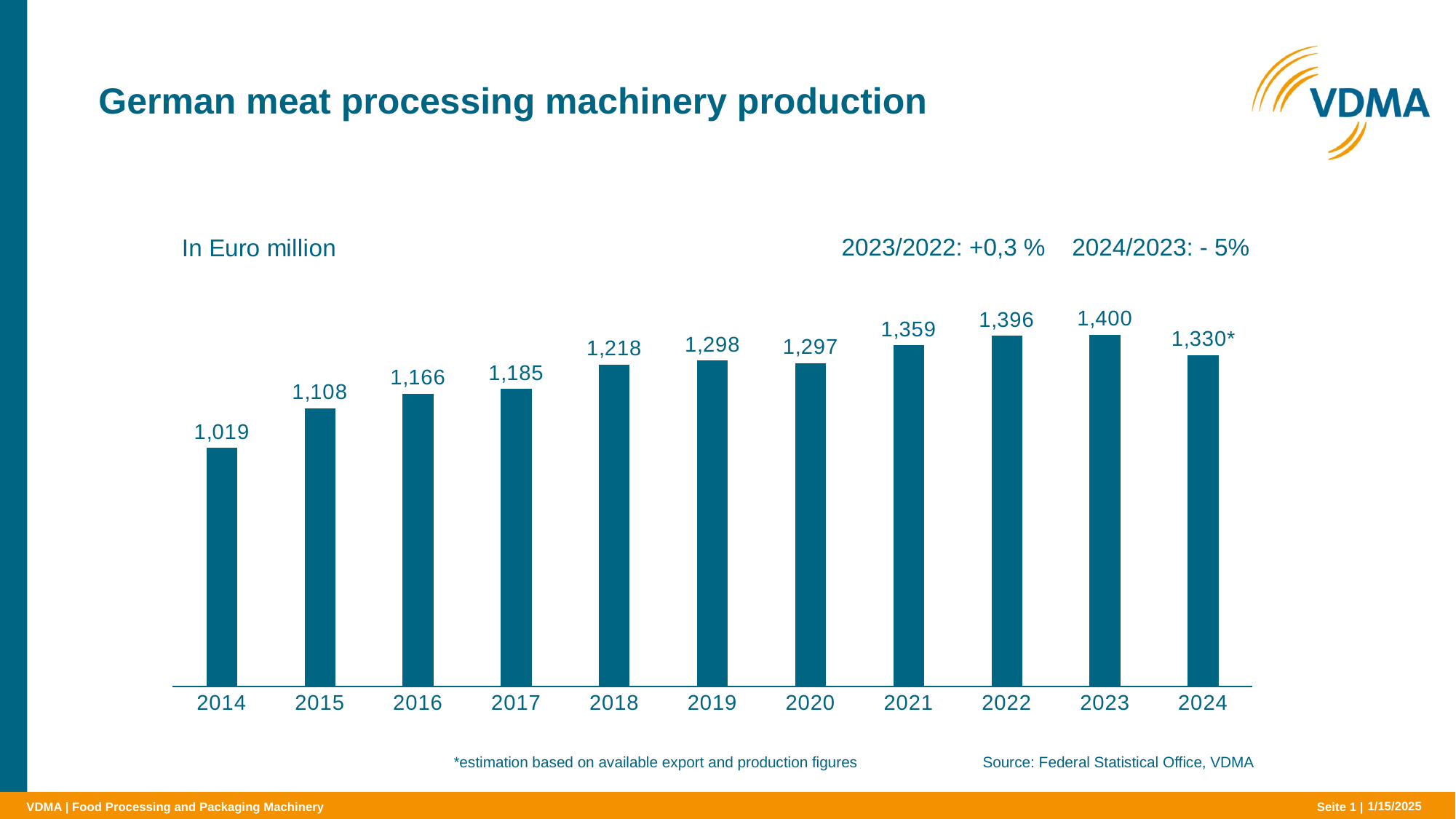
Which year has the highest value? 2023 What is the difference between the values for 2015 and 2014? 89 What is the value for 2019? 1,298 Which is larger, the value for 2021 or the value for 2020? 2021 Which year has the lowest value? 2014 What is the difference between the values for 2023 and 2022? 4 What kind of chart is this? bar chart How many years are shown on the x axis? 11 What is the value for 2024? 1,330* Do the values generally rise or fall from 2014 to 2023? rise What unit is stated for the values in the chart? In Euro million What is the value for 2014? 1,019